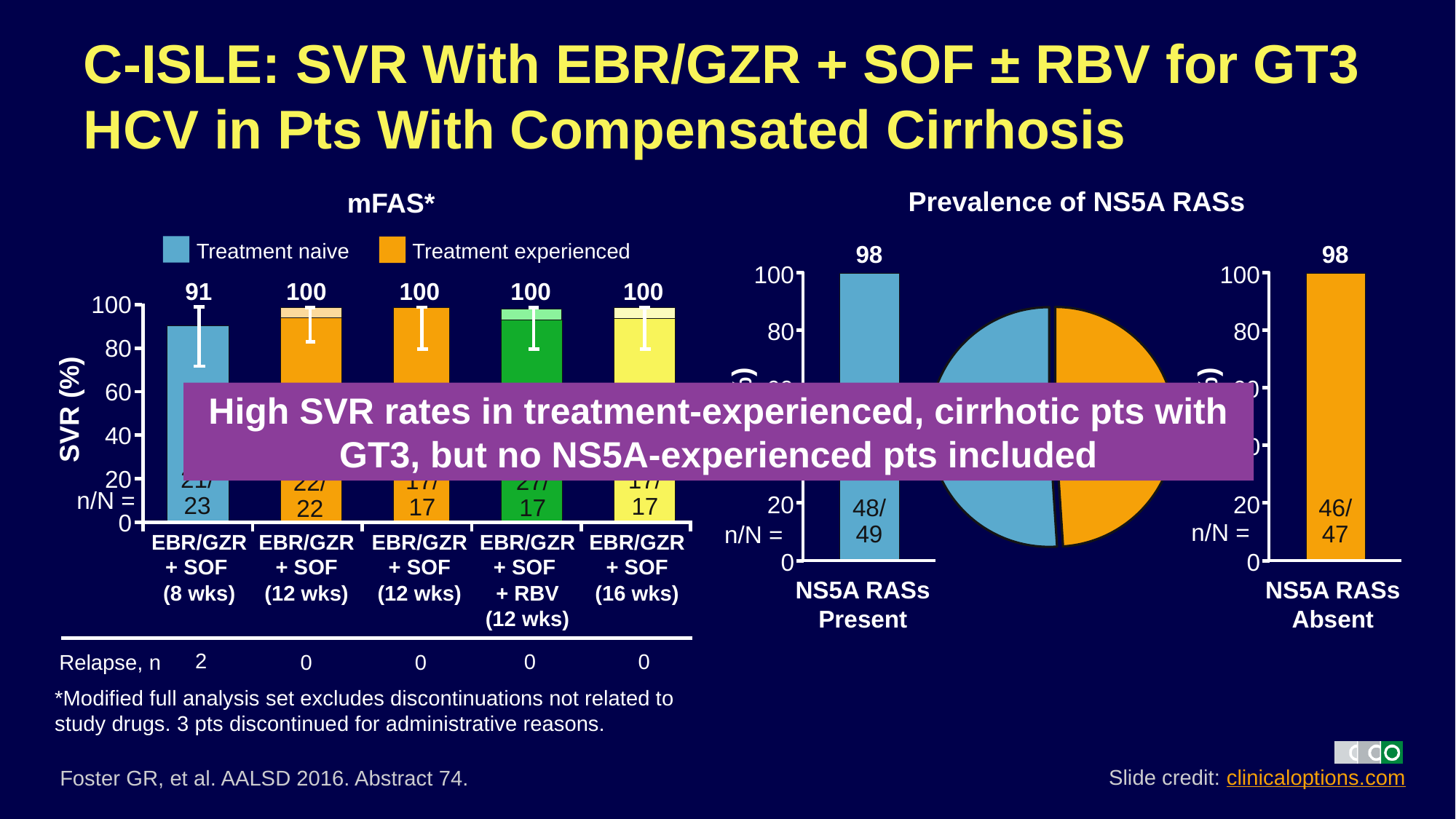
How many series does the legend of the mFAS chart list? 2 In the mFAS chart, what is the SVR (%) for EBR/GZR + SOF + RBV (12 wks)? 100 In the mFAS chart, what is the SVR (%) for EBR/GZR + SOF (8 wks)? 91 What kind of chart is the mFAS chart? Bar chart In the Prevalence of NS5A RASs section, what is the SVR (%) for patients with NS5A RASs Present? 98 In the mFAS chart, what is the n/N shown for EBR/GZR + SOF (16 wks)? 17/17 In the mFAS chart, how many treatment arms (bars) are shown? 5 In the Prevalence of NS5A RASs section, what is the n/N for patients with NS5A RASs Absent? 46/47 In the mFAS chart, which legend entry is shown in blue? Treatment naive In the mFAS chart, is the SVR for EBR/GZR + SOF (8 wks) greater or less than 80? greater In the mFAS chart, which treatment arm has the lowest SVR rate? EBR/GZR + SOF (8 wks) In the mFAS chart, what is the difference in SVR (%) between EBR/GZR + SOF (12 wks) and EBR/GZR + SOF (8 wks)? 9